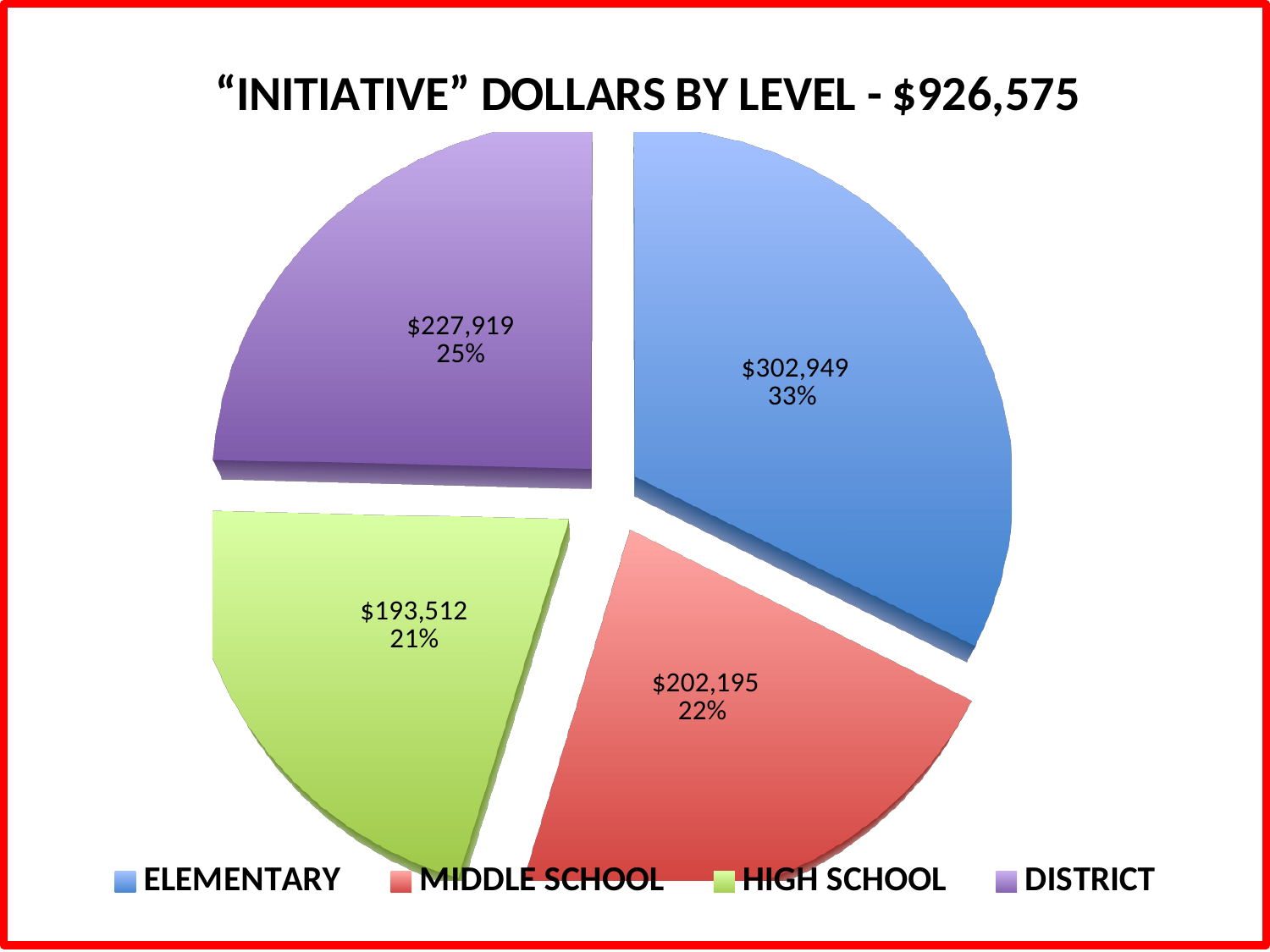
What is the dollar value for HIGH SCHOOL? $193,512 What is the difference in dollars between ELEMENTARY and HIGH SCHOOL? $109,437 What is the dollar value for MIDDLE SCHOOL? $202,195 What is the dollar value for DISTRICT? $227,919 How many slices does the pie chart have? 4 Which level receives the smallest share of initiative dollars? HIGH SCHOOL What total dollar amount is stated in the chart title? $926,575 What percentage share of the pie does MIDDLE SCHOOL represent? 22% What type of chart is shown on the slide? Pie chart Which level receives the largest share of initiative dollars? ELEMENTARY What percentage share of the pie does DISTRICT represent? 25% What is the dollar value for ELEMENTARY? $302,949